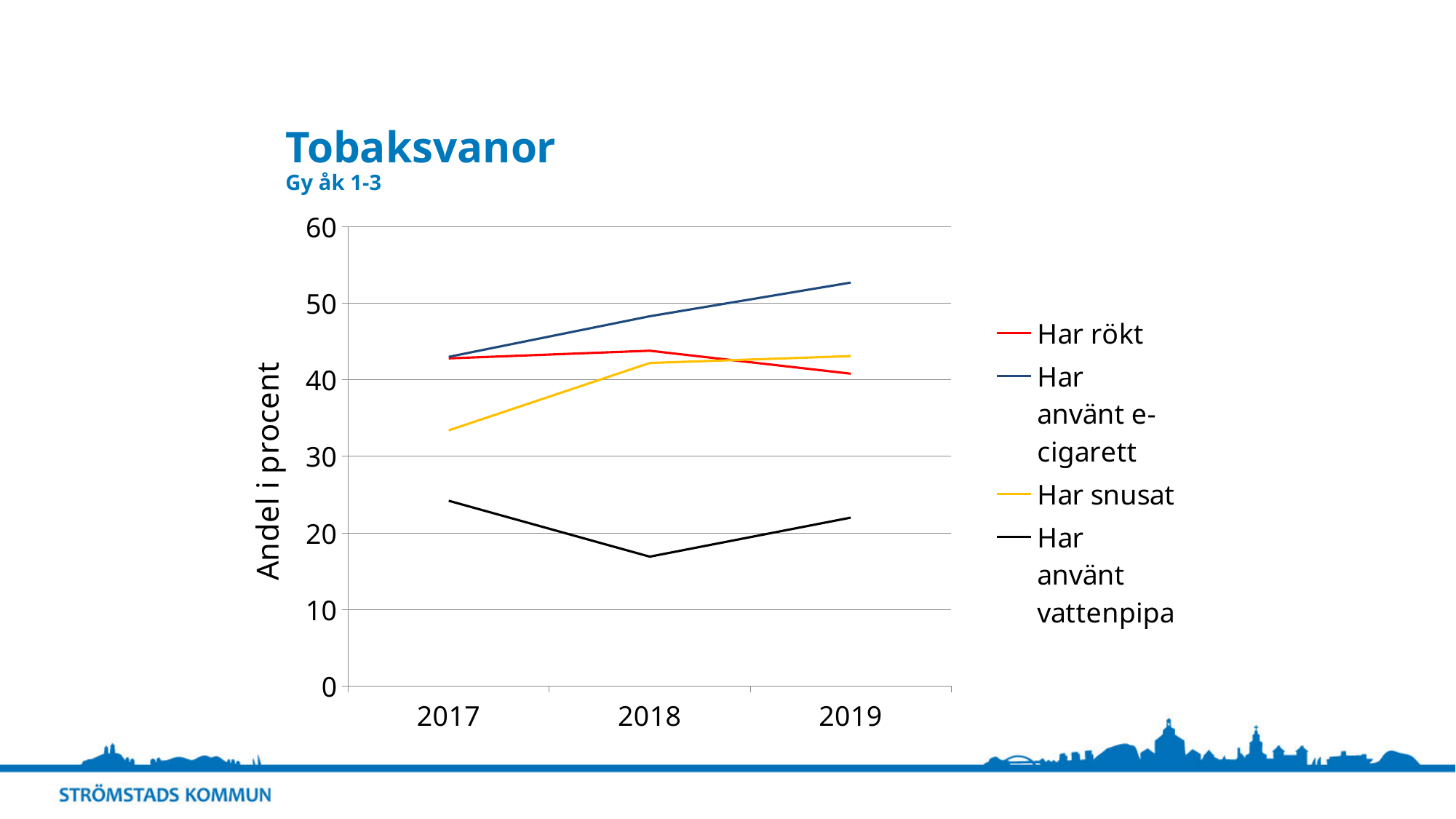
What kind of chart is shown on the slide? line chart What is the title of the slide? Tobaksvanor What is the label on the y axis? Andel i procent Is the value for "Har snusat" in 2017 greater or less than 40? less How many series does the legend list? 4 Does the value for "Har använt e-cigarett" rise or fall from 2017 to 2019? rise Which series has the highest value in 2019? Har använt e-cigarett Which series has the lowest value in 2018? Har använt vattenpipa How many years are shown on the x axis? 3 Which is larger in 2017: the value for "Har snusat" or the value for "Har rökt"? Har rökt Is the value for "Har använt e-cigarett" in 2019 greater or less than 50? greater Is the value for "Har använt vattenpipa" in 2018 greater or less than 20? less